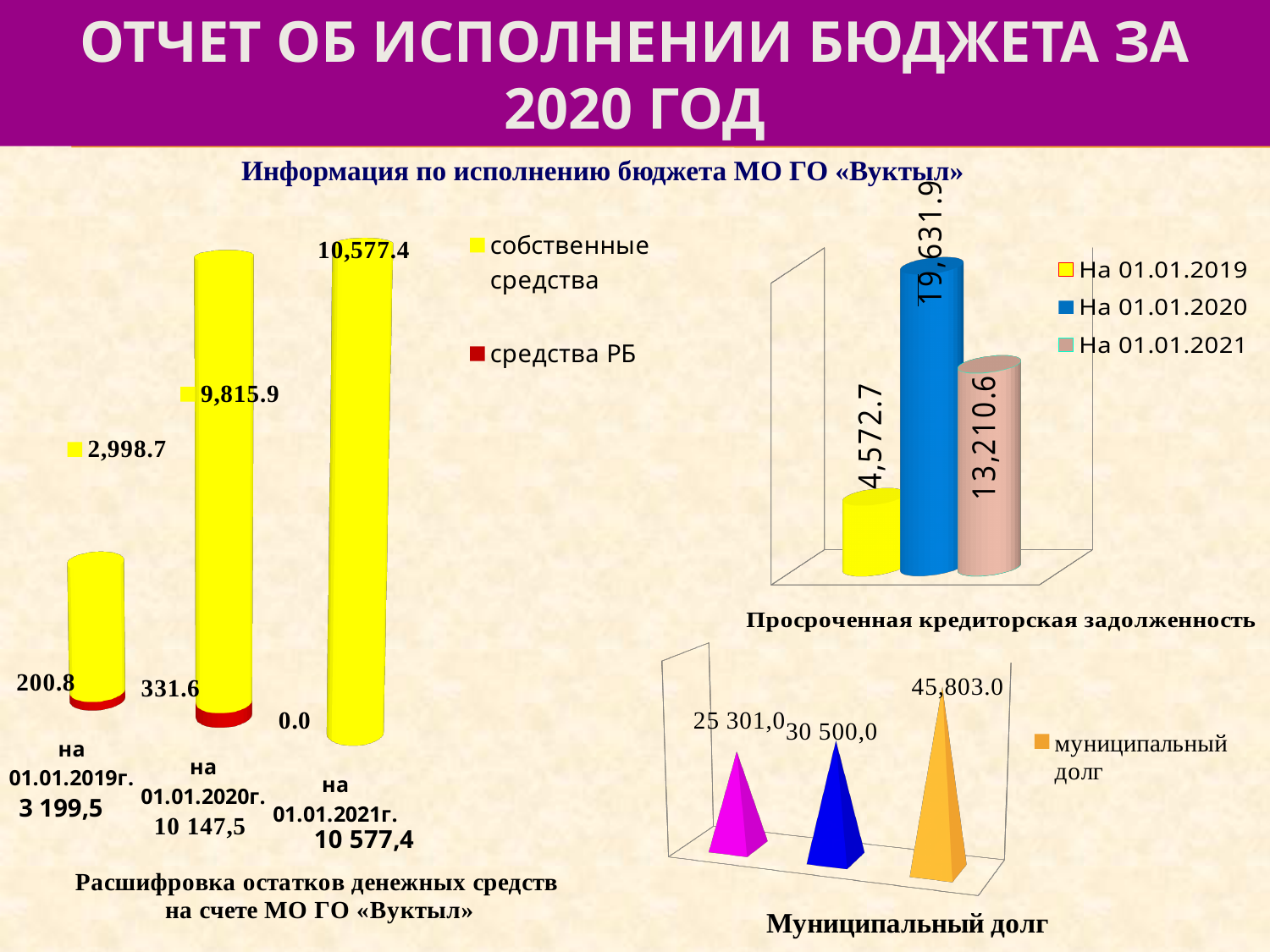
In the chart 'Просроченная кредиторская задолженность', what is the difference between the values for 'На 01.01.2020' and 'На 01.01.2019'? 15,059.2 In the chart 'Просроченная кредиторская задолженность', what is the value for 'На 01.01.2020'? 19,631.9 In the chart 'Муниципальный долг', how many bars are plotted? 3 In the chart 'Просроченная кредиторская задолженность', which series has the lowest value? На 01.01.2019 In the chart 'Муниципальный долг', what is the highest value shown? 45,803.0 In the chart 'Просроченная кредиторская задолженность', which is larger: the value for 'На 01.01.2020' or 'На 01.01.2021'? На 01.01.2020 In the chart 'Расшифровка остатков денежных средств на счете МО ГО «Вуктыл»', what is the value of 'средства РБ' for 'на 01.01.2021г.'? 0.0 In the chart 'Расшифровка остатков денежных средств на счете МО ГО «Вуктыл»', what is the value of 'средства РБ' for 'на 01.01.2019г.'? 200.8 In the chart 'Расшифровка остатков денежных средств на счете МО ГО «Вуктыл»', what is the total of the stacked bar for 'на 01.01.2020г.'? 10 147,5 In the chart 'Расшифровка остатков денежных средств на счете МО ГО «Вуктыл»', what is the value of 'собственные средства' for 'на 01.01.2020г.'? 9,815.9 In the chart 'Расшифровка остатков денежных средств на счете МО ГО «Вуктыл»', how many series does the legend list? 2 In the chart 'Расшифровка остатков денежных средств на счете МО ГО «Вуктыл»', which category has the highest value of 'собственные средства'? на 01.01.2021г.